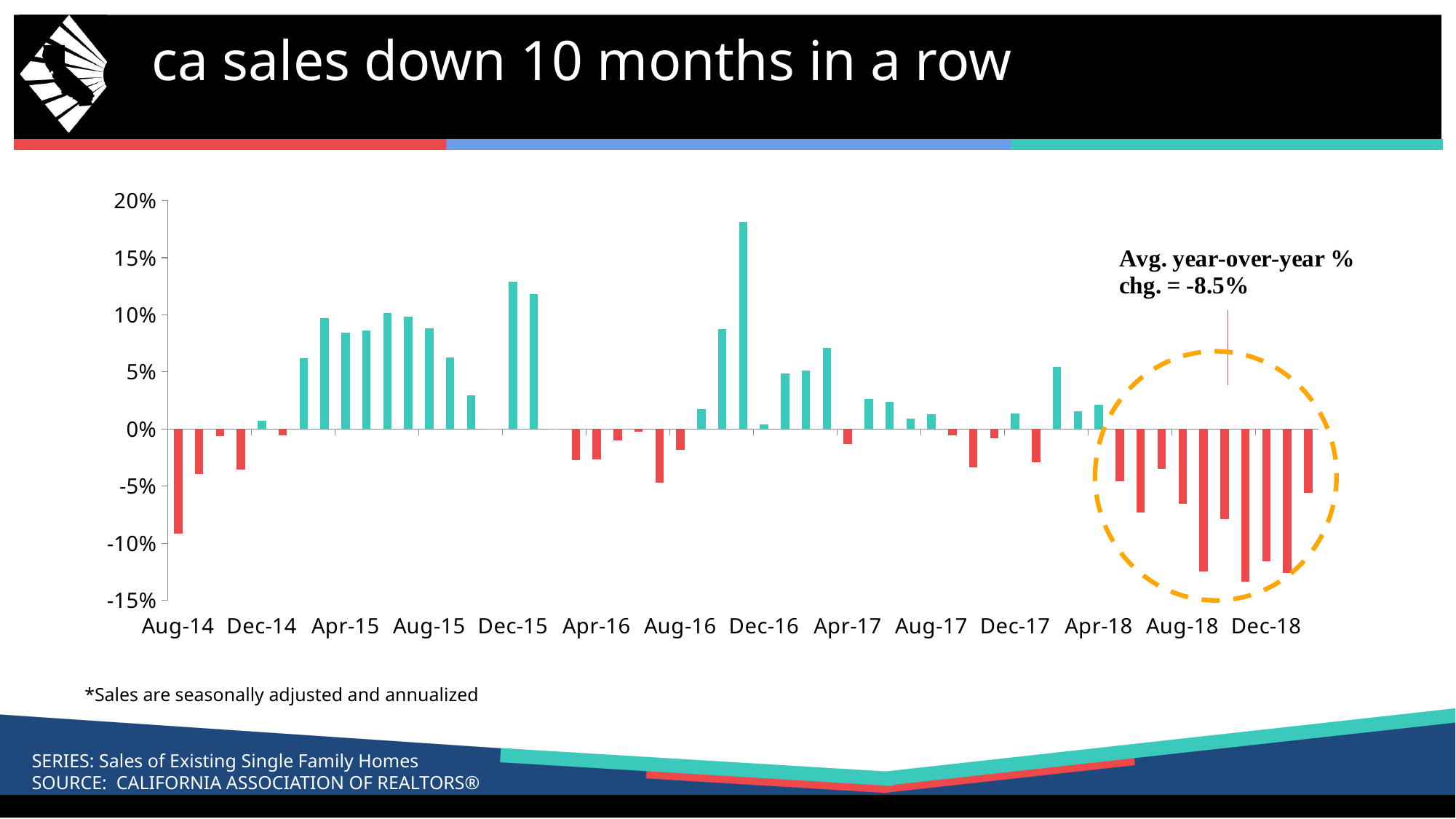
Is the value for Apr-17 greater or less than 5%? less Is the value for Dec-18 greater or less than -10%? less Are the bars from Aug-18 through Dec-18 above or below 0%? below Is the value for Aug-17 greater or less than 5%? less What kind of chart is shown on the slide? bar chart What is the title of the slide containing the chart? ca sales down 10 months in a row In which year does the highest bar on the chart occur? 2016 Which is larger, the value for Dec-15 or the value for Apr-15? Dec-15 Which is larger, the value for Aug-14 or the value for Dec-14? Dec-14 What is the average year-over-year % change stated in the annotation on the chart? -8.5%